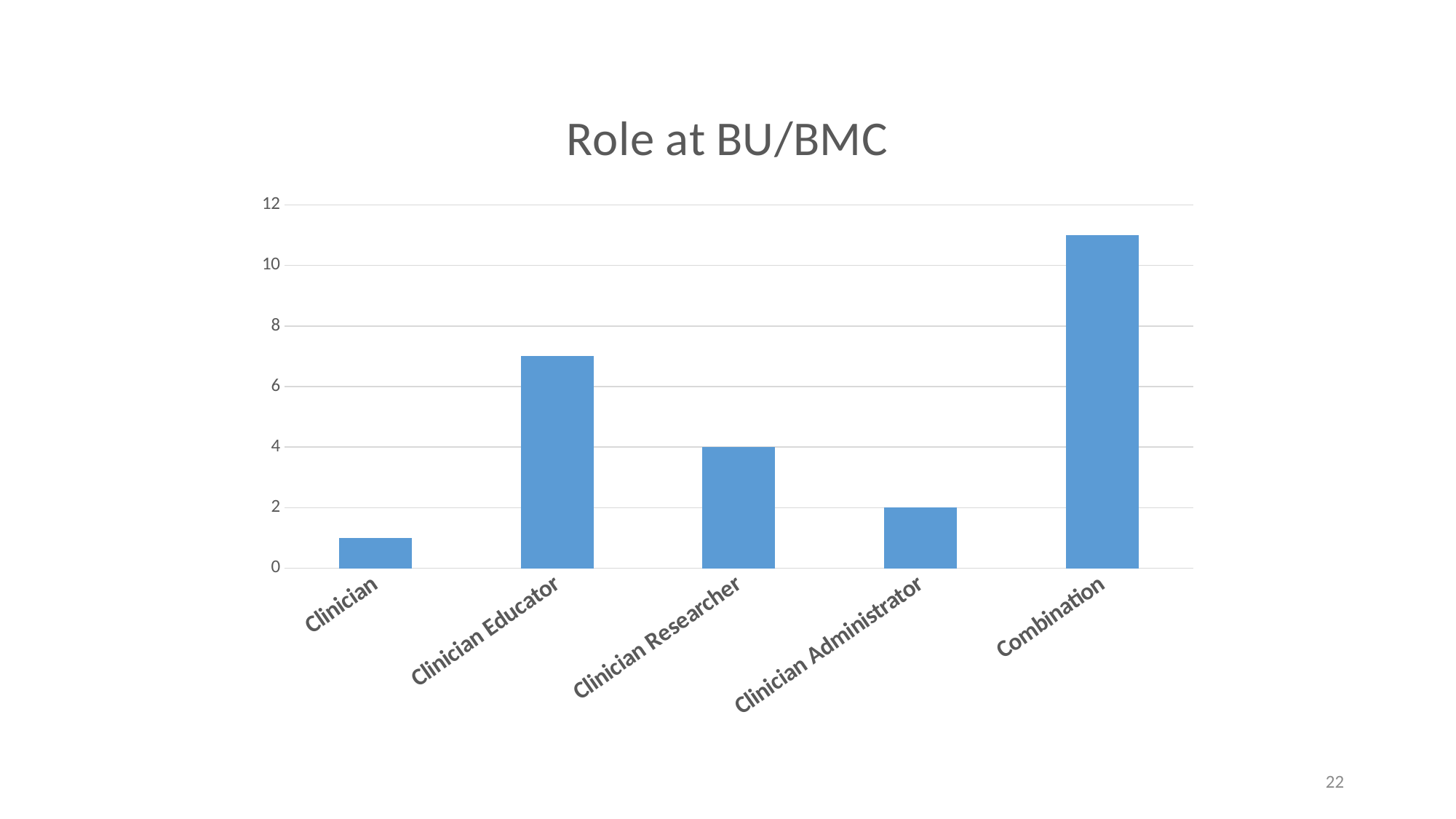
How many categories are shown on the x axis? 5 What is the title of the chart? Role at BU/BMC Which category has the lowest value? Clinician What type of chart is shown on the slide? bar chart Which category has the highest value? Combination What is the value for Clinician Researcher? 4 Is the value for Clinician Educator greater or less than 6? greater Is the value for Combination greater or less than 10? greater What is the difference between the values for Clinician Researcher and Clinician Administrator? 2 What is the value for Clinician Administrator? 2 Is the value for Clinician greater or less than 2? less Which is larger, the value for Clinician Educator or the value for Clinician Researcher? Clinician Educator